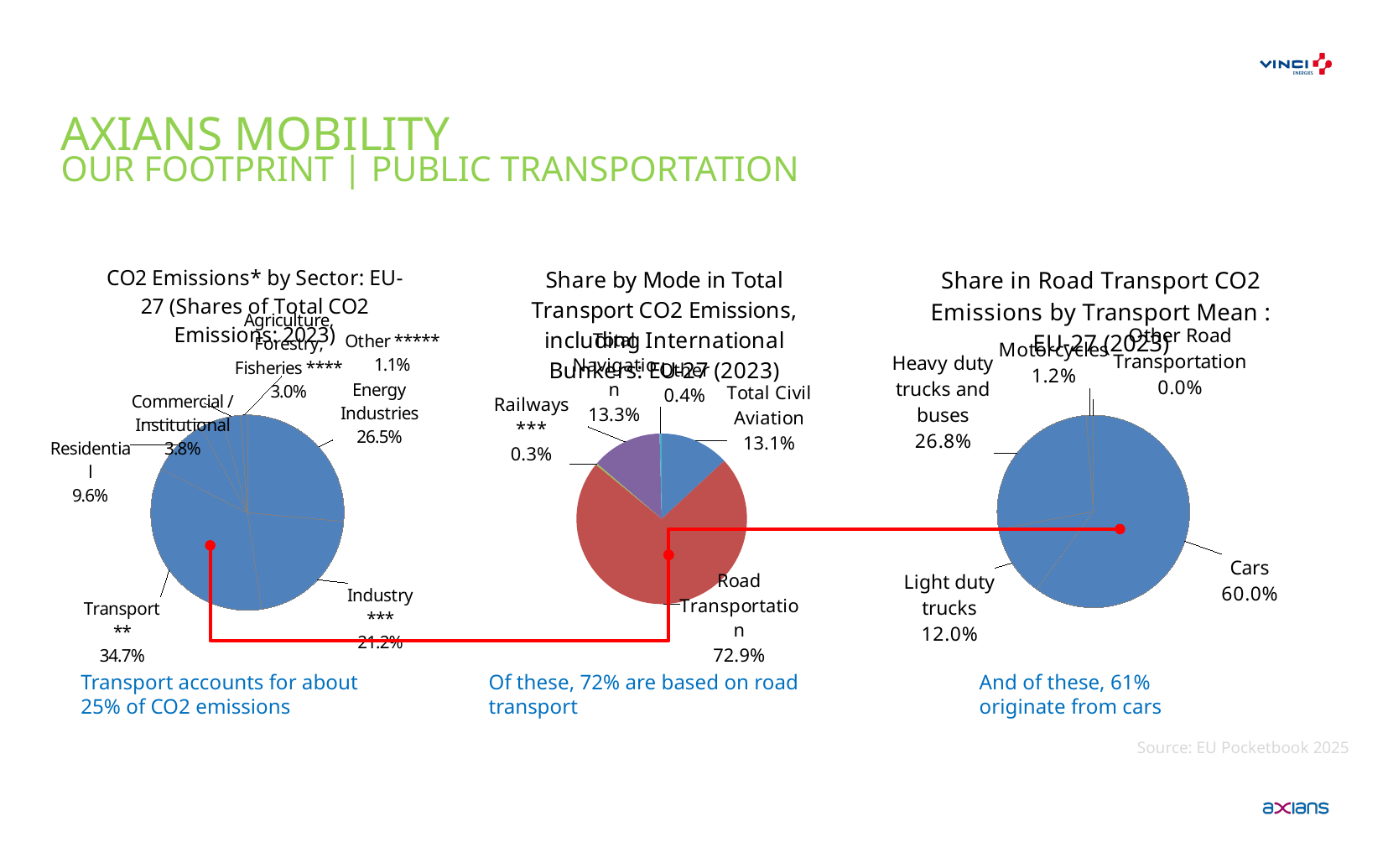
In the left chart (CO2 Emissions by Sector), what share is shown for Transport? 34.7% In the middle chart (Share by Mode in Total Transport CO2 Emissions), what share is shown for Road Transportation? 72.9% What type of chart is used for the three charts on the slide? Pie chart In the right chart (Share in Road Transport CO2 Emissions by Transport Mean), what share is shown for Cars? 60.0% In the middle chart (Share by Mode in Total Transport CO2 Emissions), what share is shown for Total Civil Aviation? 13.1% In the left chart (CO2 Emissions by Sector), which is larger, Residential or Commercial / Institutional? Residential In the middle chart (Share by Mode in Total Transport CO2 Emissions), what share is shown for Railways? 0.3% In the left chart (CO2 Emissions by Sector), what is the difference between the Transport share and the Industry share? 13.5% In the right chart (Share in Road Transport CO2 Emissions by Transport Mean), what share is shown for Heavy duty trucks and buses? 26.8% In the left chart (CO2 Emissions by Sector), what share is shown for Energy Industries? 26.5% In the left chart (CO2 Emissions by Sector), which sector has the largest share? Transport In the right chart (Share in Road Transport CO2 Emissions by Transport Mean), what is the difference between the Cars share and the Light duty trucks share? 48.0%